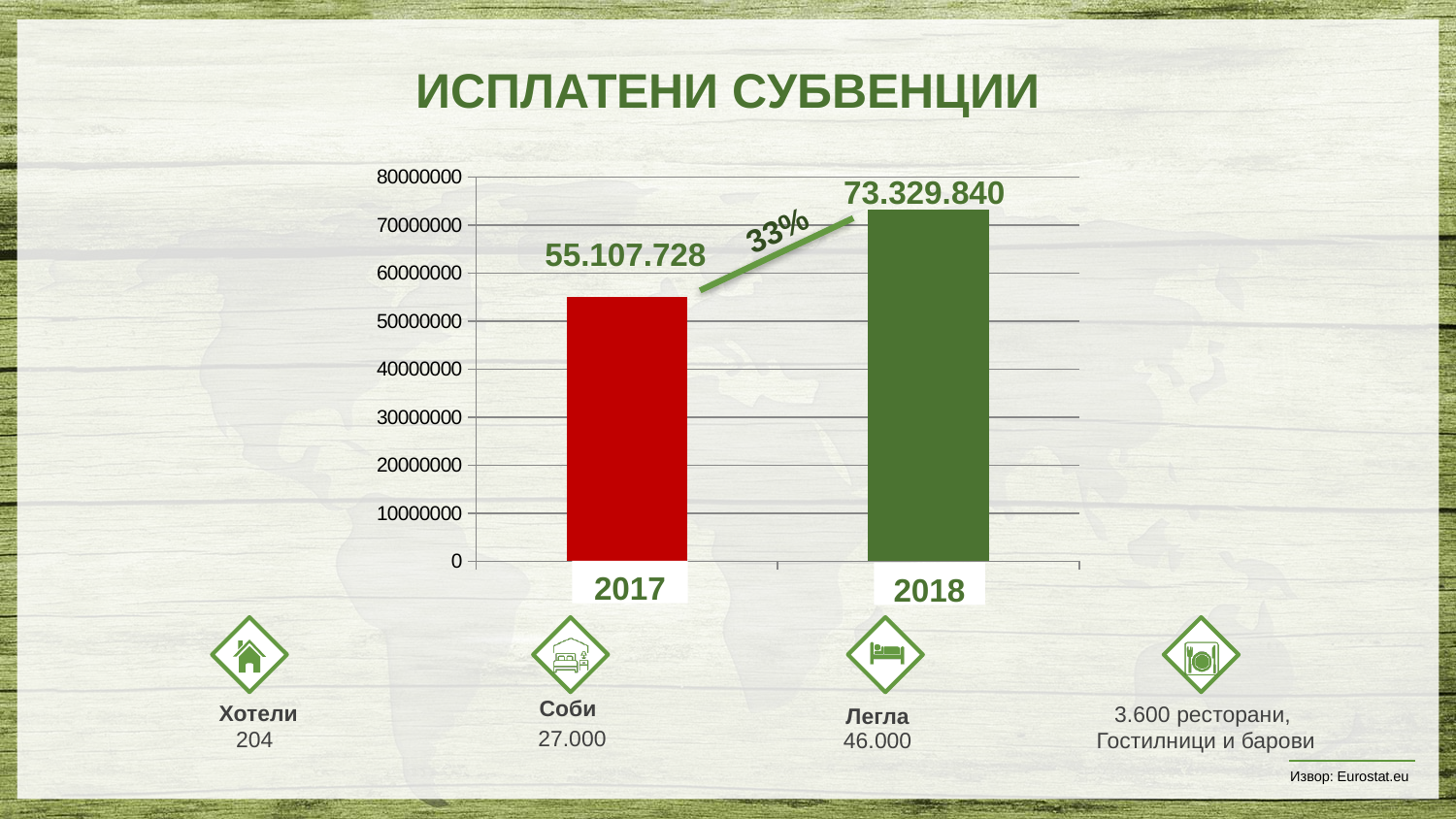
What is the value for 2018? 73.329.840 What is the difference between the values for 2018 and 2017? 18.222.112 Do the values rise or fall from 2017 to 2018? rise What kind of chart is shown on the slide? bar chart What percentage change is annotated between the 2017 and 2018 bars? 33% Which year has the highest value? 2018 Is the value for 2018 greater or less than 70000000? greater Which year has the lowest value? 2017 Which is larger, the value for 2017 or the value for 2018? 2018 What is the value for 2017? 55.107.728 How many bars are shown in the chart? 2 Is the value for 2017 greater or less than 60000000? less